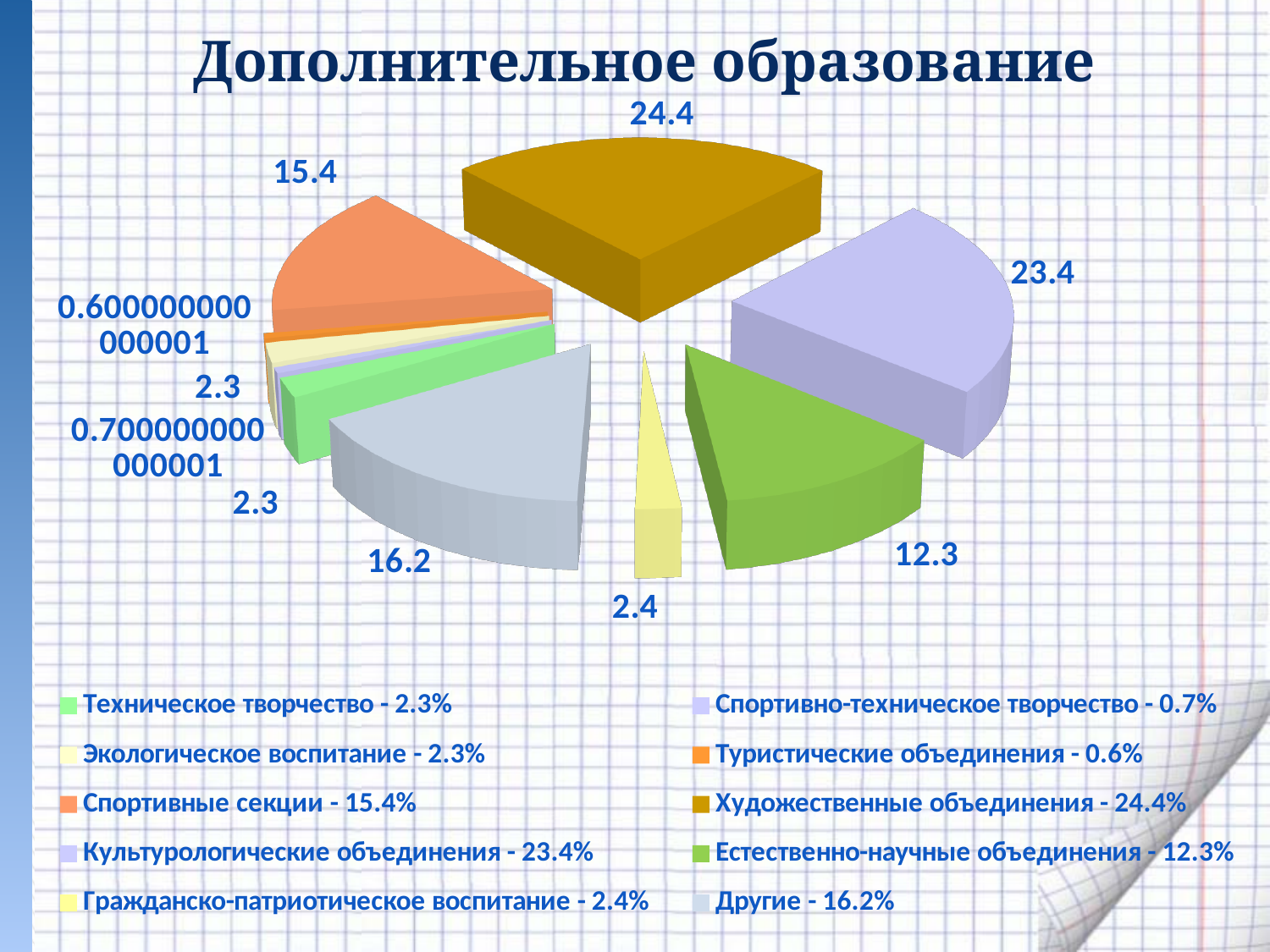
What value is printed on the slice for Культурологические объединения? 23.4 Which category has the smallest slice? Туристические объединения What value is printed on the slice for Художественные объединения? 24.4 What kind of chart is shown on the slide? pie chart What is the title of the chart? Дополнительное образование How many slices does the pie chart have? 10 What value is printed on the slice for Естественно-научные объединения? 12.3 Which category has the largest slice? Художественные объединения According to the legend, what share does Спортивные секции have? 15.4% Which is larger, the slice for Другие or the slice for Спортивные секции? Другие What is the difference between the values for Художественные объединения and Культурологические объединения? 1.0 According to the legend, what share does Другие have? 16.2%